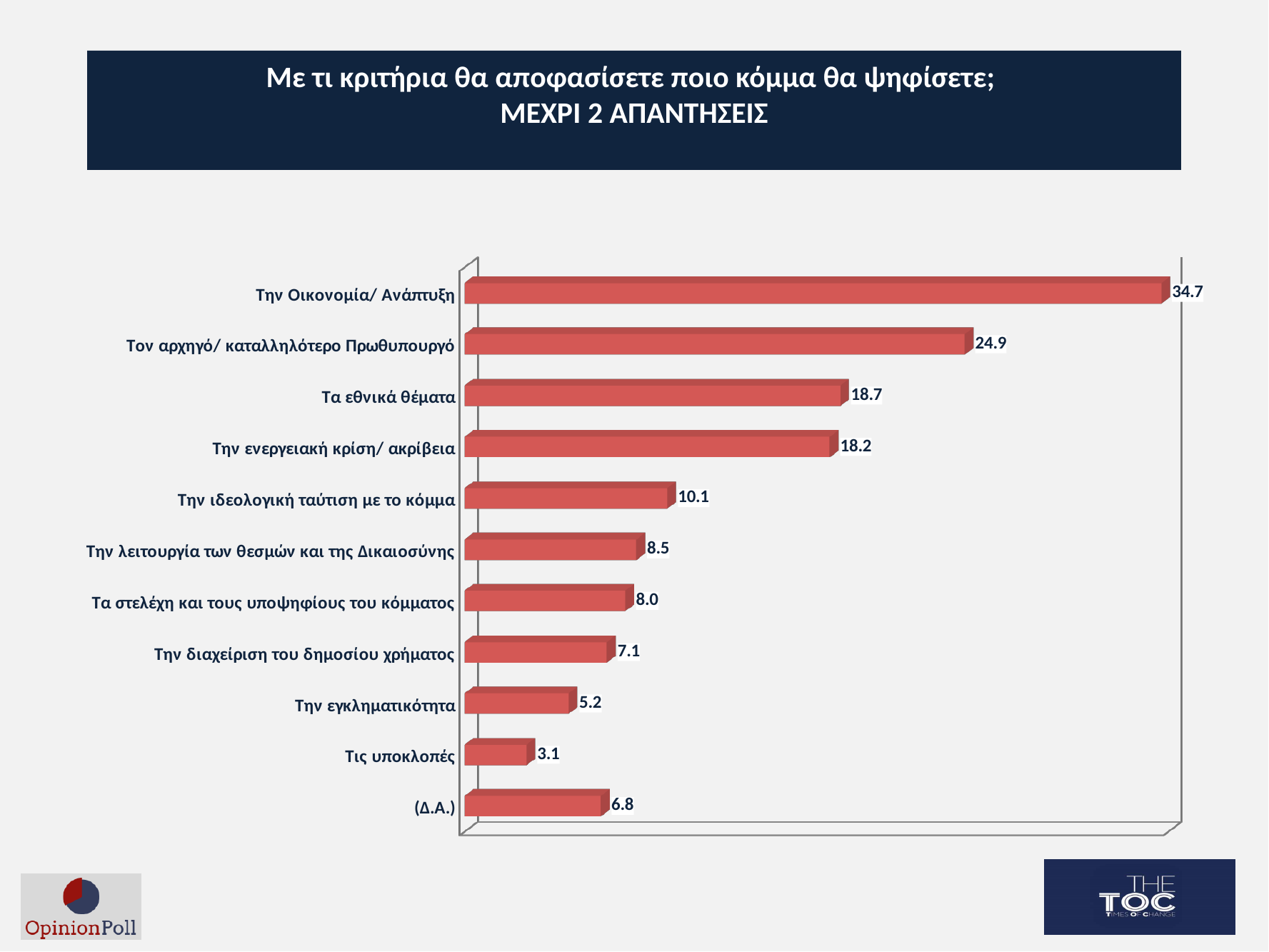
What is the value for "Την Οικονομία/ Ανάπτυξη"? 34.7 What kind of chart is shown on the slide? Bar chart What is the title of the chart? Με τι κριτήρια θα αποφασίσετε ποιο κόμμα θα ψηφίσετε; ΜΕΧΡΙ 2 ΑΠΑΝΤΗΣΕΙΣ Which category has the highest value? Την Οικονομία/ Ανάπτυξη What is the difference between the values for "Τα εθνικά θέματα" and "Την ενεργειακή κρίση/ ακρίβεια"? 0.5 Which category has the lowest value? Τις υποκλοπές What is the value for "Τα εθνικά θέματα"? 18.7 Which is larger, the value for "Την ιδεολογική ταύτιση με το κόμμα" or the value for "Την λειτουργία των θεσμών και της Δικαιοσύνης"? Την ιδεολογική ταύτιση με το κόμμα How many categories are shown in the chart? 11 What is the value for "Τις υποκλοπές"? 3.1 What is the value for "(Δ.Α.)"? 6.8 What is the difference between the values for "Την Οικονομία/ Ανάπτυξη" and "Τον αρχηγό/ καταλληλότερο Πρωθυπουργό"? 9.8